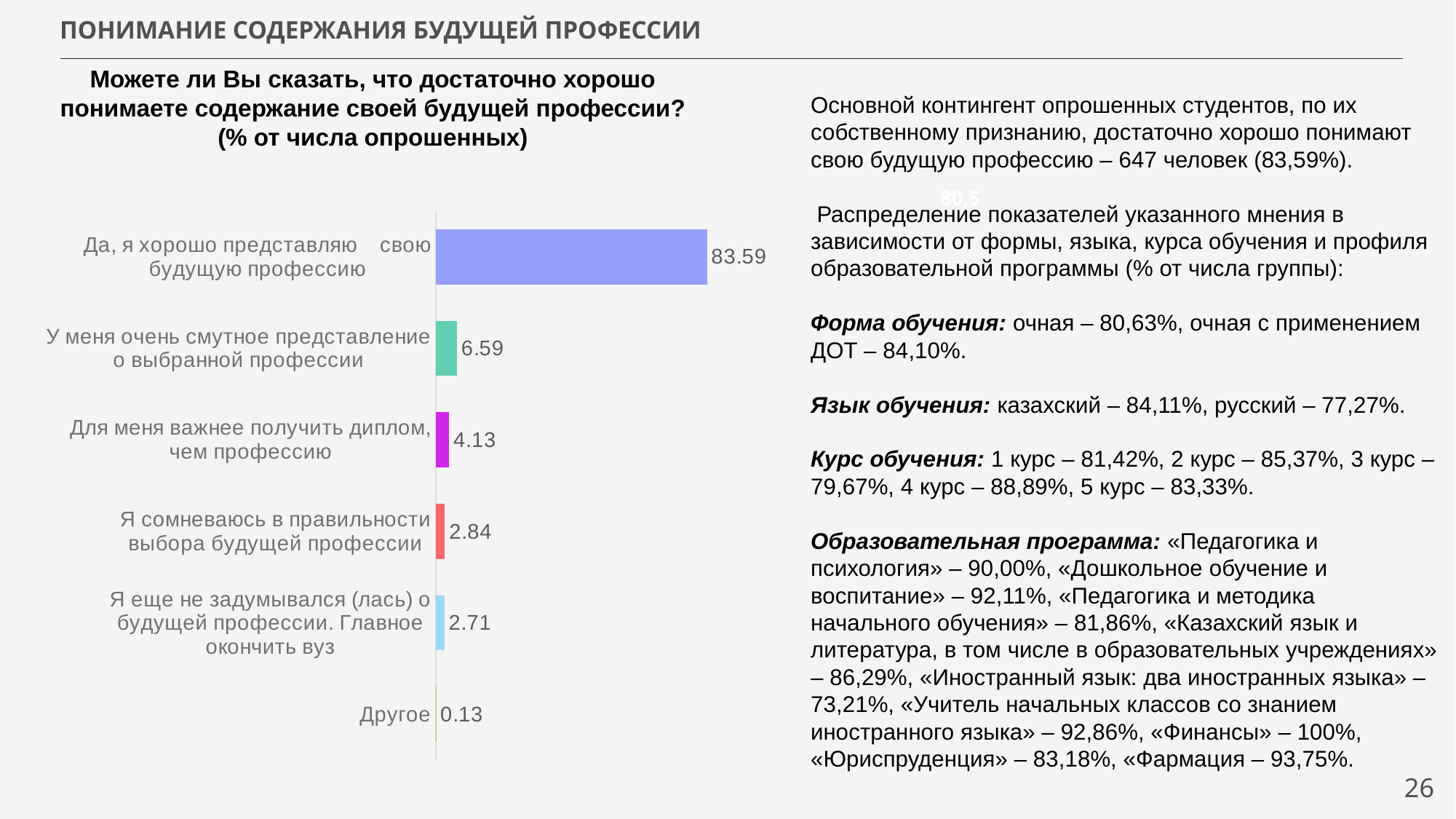
What is the difference between the values for "Для меня важнее получить диплом, чем профессию" and "Я сомневаюсь в правильности выбора будущей профессии"? 1.29 What is the value for "У меня очень смутное представление о выбранной профессии"? 6.59 What is the value for "Да, я хорошо представляю свою будущую профессию"? 83.59 What is the value for "Для меня важнее получить диплом, чем профессию"? 4.13 What type of chart is shown on the slide? bar chart What is the value for "Другое"? 0.13 Which category has the highest value? Да, я хорошо представляю свою будущую профессию What is the difference between the values for "Да, я хорошо представляю свою будущую профессию" and "У меня очень смутное представление о выбранной профессии"? 77.00 What is the value for "Я сомневаюсь в правильности выбора будущей профессии"? 2.84 Which is larger: the value for "Я сомневаюсь в правильности выбора будущей профессии" or the value for "Я еще не задумывался (лась) о будущей профессии. Главное окончить вуз"? Я сомневаюсь в правильности выбора будущей профессии Which category has the lowest value? Другое How many categories are shown in the chart? 6